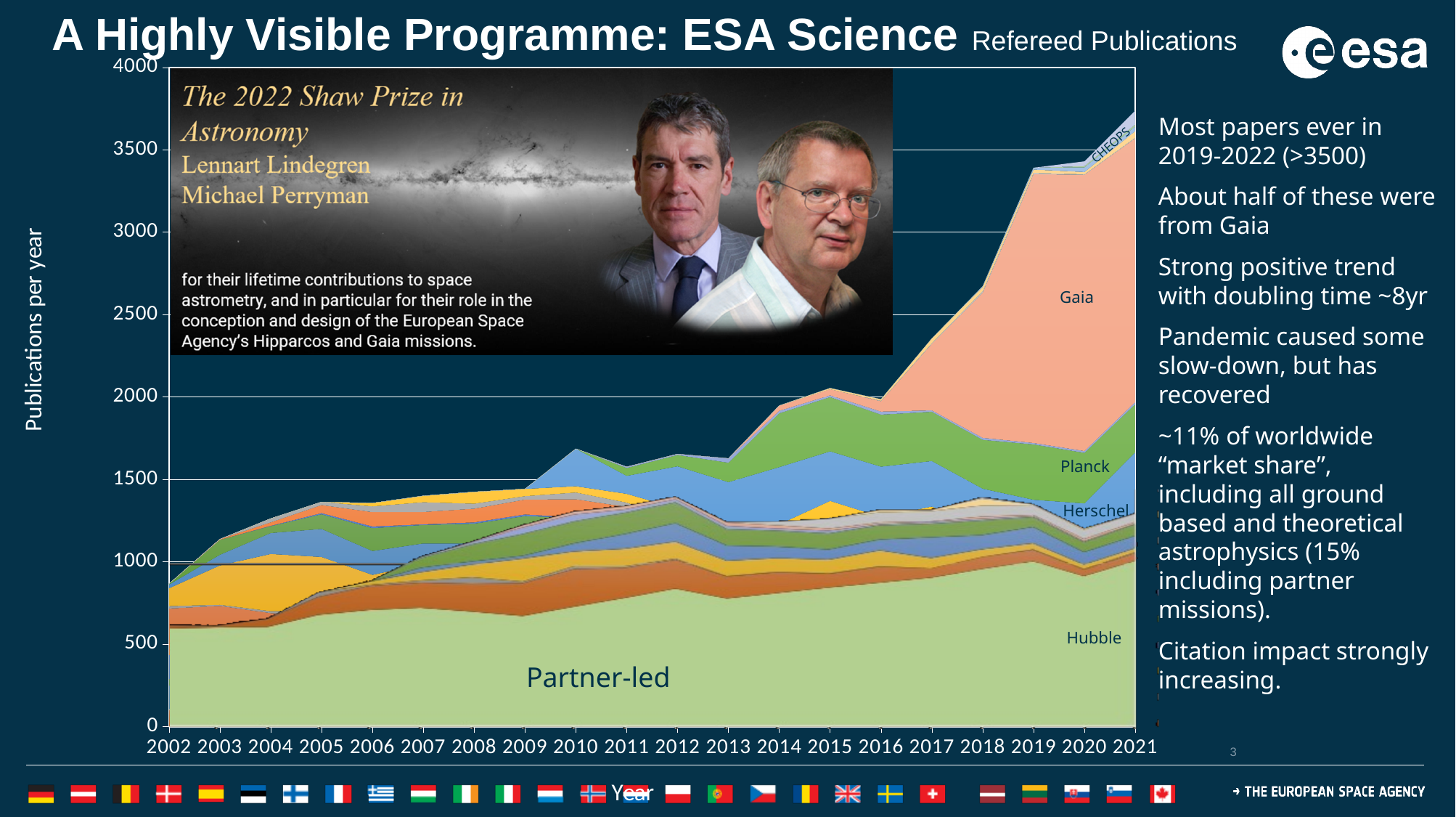
What kind of chart is shown on the slide? Stacked area chart Is the total number of publications in 2010 greater or less than 1500? greater Which year has the lowest total number of publications? 2002 Which mission accounts for the largest share of publications in 2021? Gaia How many years are shown along the x axis of the chart? 20 Is the total number of publications in 2021 greater or less than 3500? greater What is the label of the y axis? Publications per year Is the total number of publications in 2019 greater or less than 3000? greater Which year has the highest total number of publications? 2021 What is the first year shown on the x axis? 2002 Do total publications per year generally rise or fall from 2002 to 2021? Rise